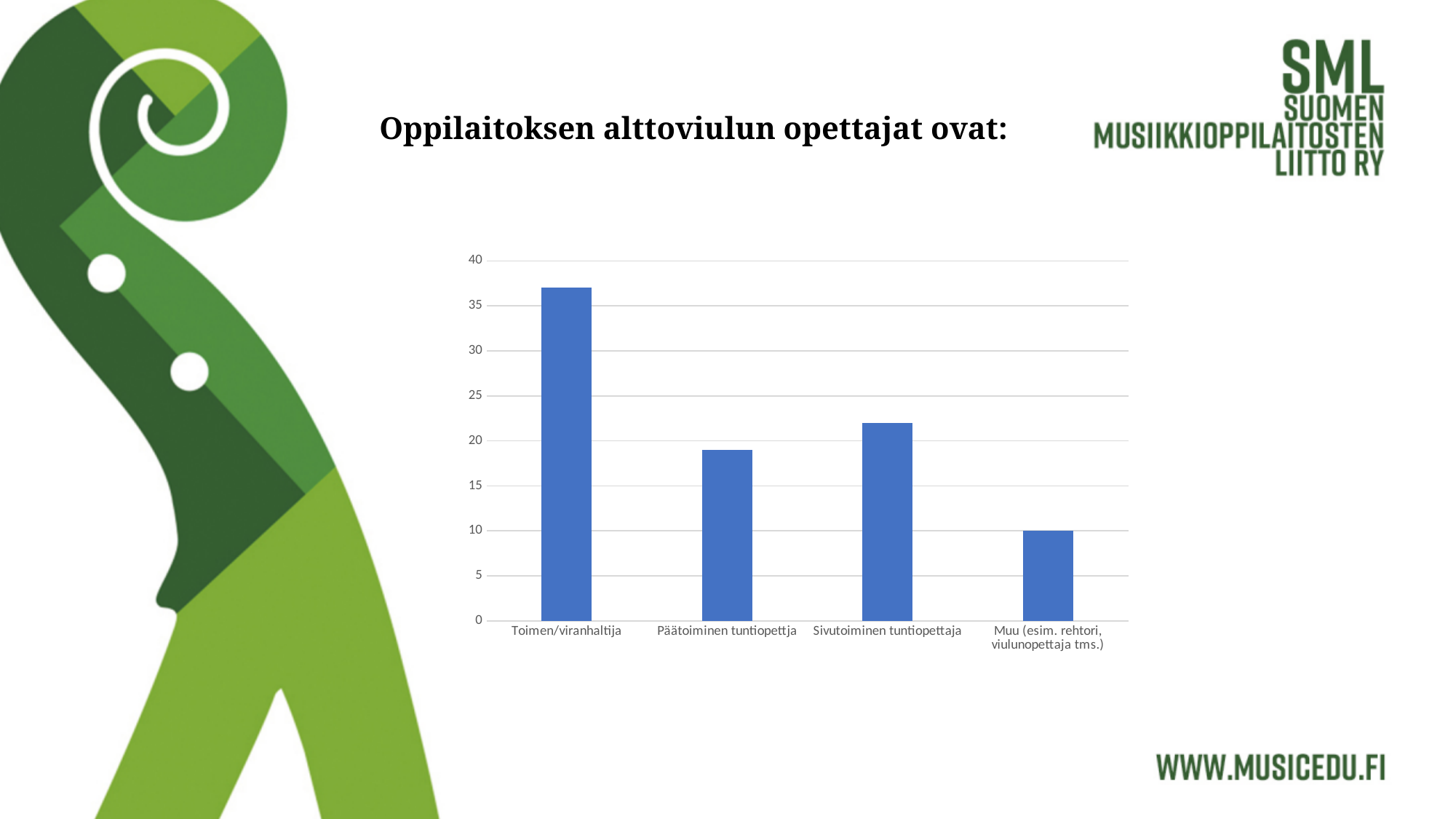
Is the value for Toimen/viranhaltija greater or less than 35? greater What kind of chart is shown on the slide? bar chart Is the value for Sivutoiminen tuntiopettaja greater or less than 20? greater Which category has the lowest bar in the chart? Muu (esim. rehtori, viulunopettaja tms.) Is the value for Toimen/viranhaltija greater or less than 40? less Which is larger, the value for Toimen/viranhaltija or the value for Muu (esim. rehtori, viulunopettaja tms.)? Toimen/viranhaltija How many categories are shown on the x axis of the chart? 4 What is the title of the slide above the chart? Oppilaitoksen alttoviulun opettajat ovat: Which is larger, the value for Sivutoiminen tuntiopettaja or the value for Päätoiminen tuntiopettaja? Sivutoiminen tuntiopettaja What colour are the bars in the chart? blue Which category has the highest bar in the chart? Toimen/viranhaltija